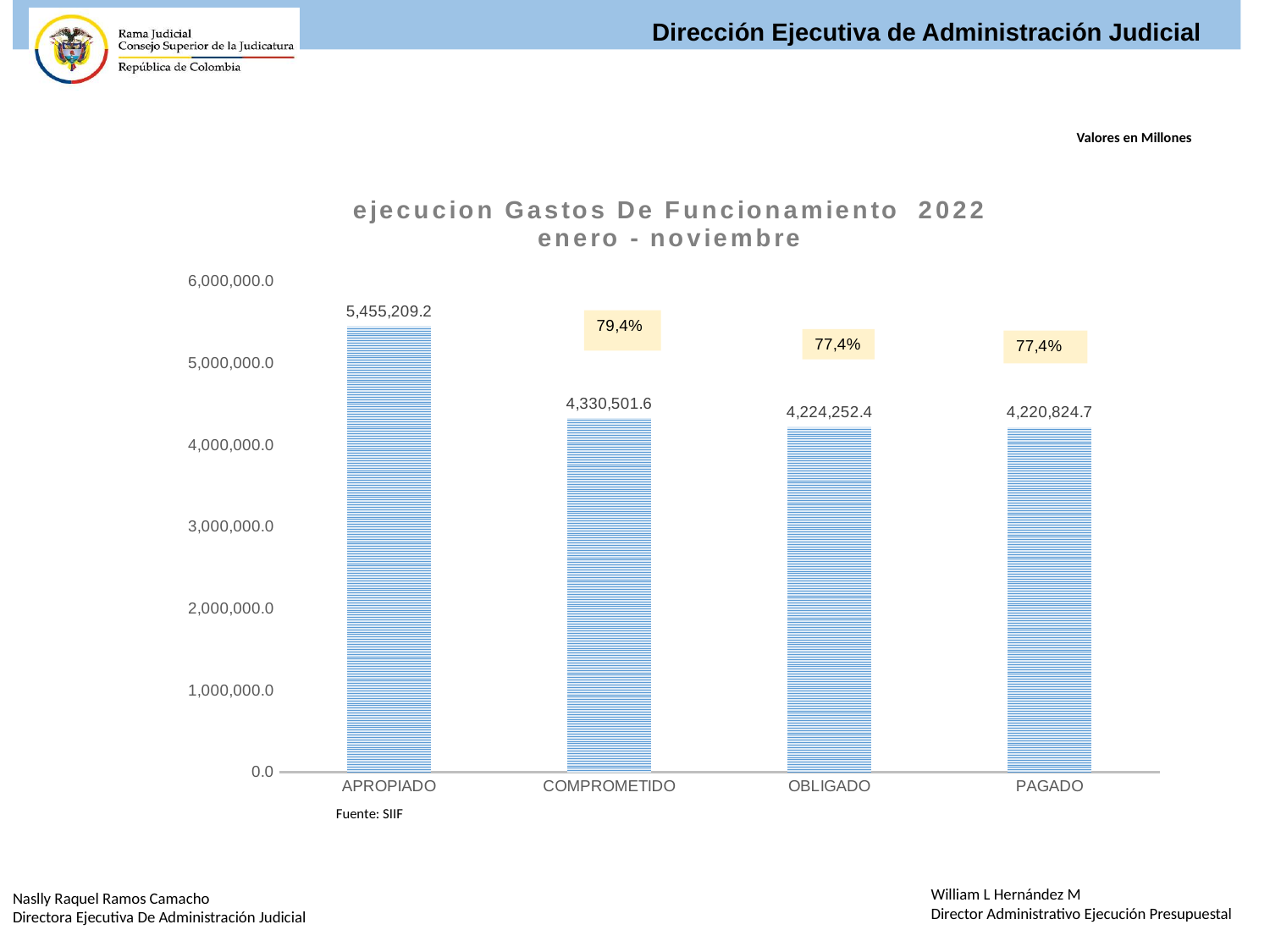
What percentage label is shown above the COMPROMETIDO bar? 79,4% What is the value for OBLIGADO? 4,224,252.4 What is the value for PAGADO? 4,220,824.7 How many categories are shown on the x axis? 4 What is the difference between the values for APROPIADO and COMPROMETIDO? 1,124,707.6 Which is larger, the value for APROPIADO or the value for OBLIGADO? APROPIADO What is the title of the chart? ejecucion Gastos De Funcionamiento 2022 enero - noviembre What is the value for APROPIADO? 5,455,209.2 Which category has the highest value? APROPIADO What kind of chart is shown on the slide? bar chart Is the value for COMPROMETIDO greater or less than 4,000,000.0? greater What is the value for COMPROMETIDO? 4,330,501.6